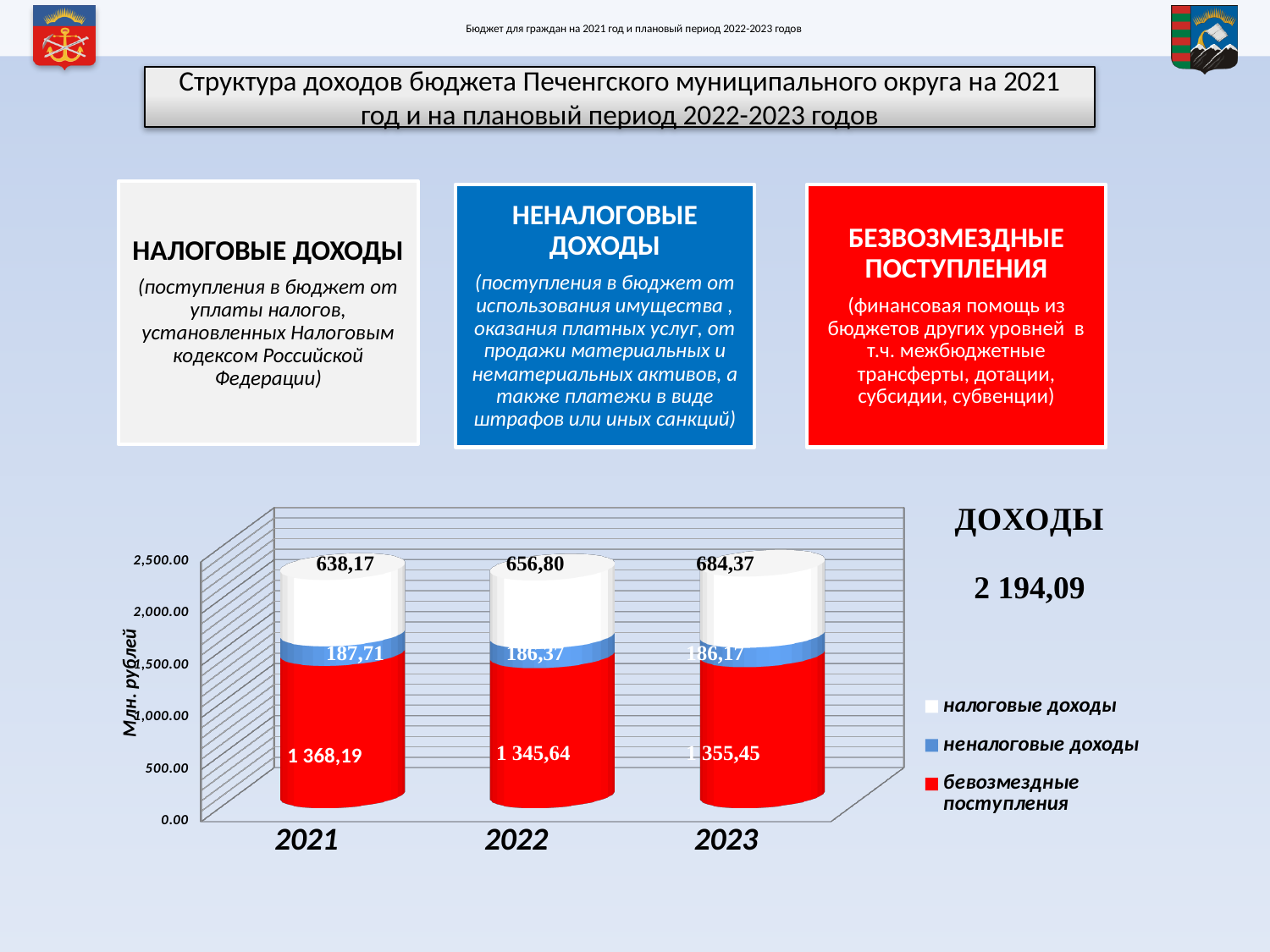
Which is larger: налоговые доходы in 2022 or in 2021? 2022 What is the difference between налоговые доходы in 2023 and in 2021? 46,20 How many years are shown on the x axis of the chart? 3 What is the difference between безвозмездные поступления in 2021 and in 2022? 22,55 In which year is the value of налоговые доходы the highest? 2023 How many series does the chart legend list? 3 What is the value of безвозмездные поступления for 2022? 1 345,64 What is the value of налоговые доходы for 2021? 638,17 Is the total height of the 2021 stacked bar greater or less than 2,000.00? greater In which year is the value of безвозмездные поступления the lowest? 2022 Do the values of налоговые доходы rise or fall from 2021 to 2023? rise What is the value of неналоговые доходы for 2023? 186,17